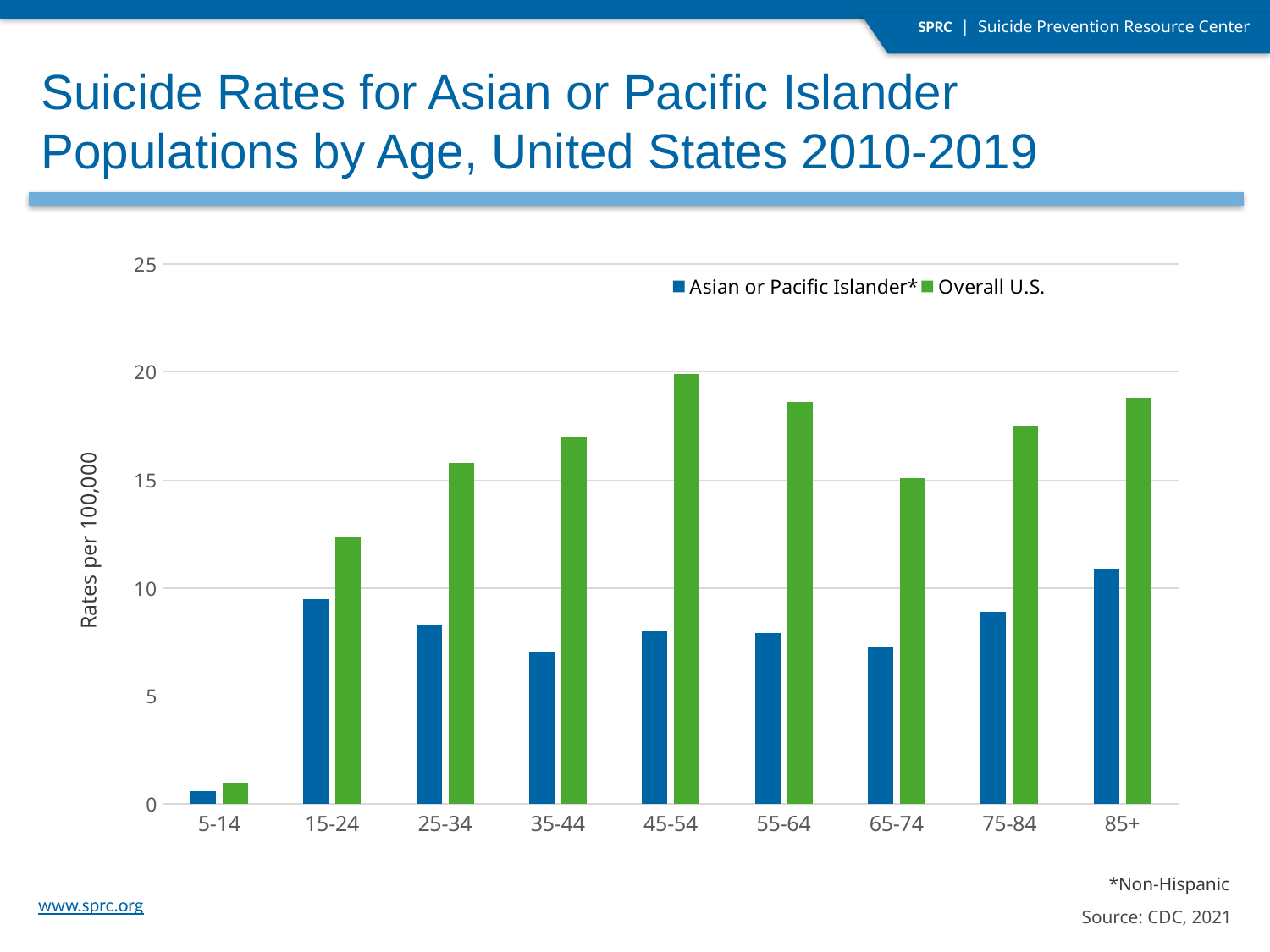
Which age group has the highest Overall U.S. suicide rate? 45-54 Which age group has the highest Asian or Pacific Islander suicide rate? 85+ Which age group has the lowest Overall U.S. suicide rate? 5-14 Which is larger for the Asian or Pacific Islander series: the 15-24 value or the 35-44 value? 15-24 How many series does the legend list? 2 What is the label on the y axis? Rates per 100,000 Is the Overall U.S. value for 45-54 greater or less than 15? greater Is the Asian or Pacific Islander value for 85+ greater or less than 10? greater What kind of chart is shown on the slide? Bar chart For the 45-54 age group, which is larger: the Asian or Pacific Islander rate or the Overall U.S. rate? Overall U.S. Is the Overall U.S. value for 15-24 greater or less than 15? less How many age groups are shown on the x axis? 9